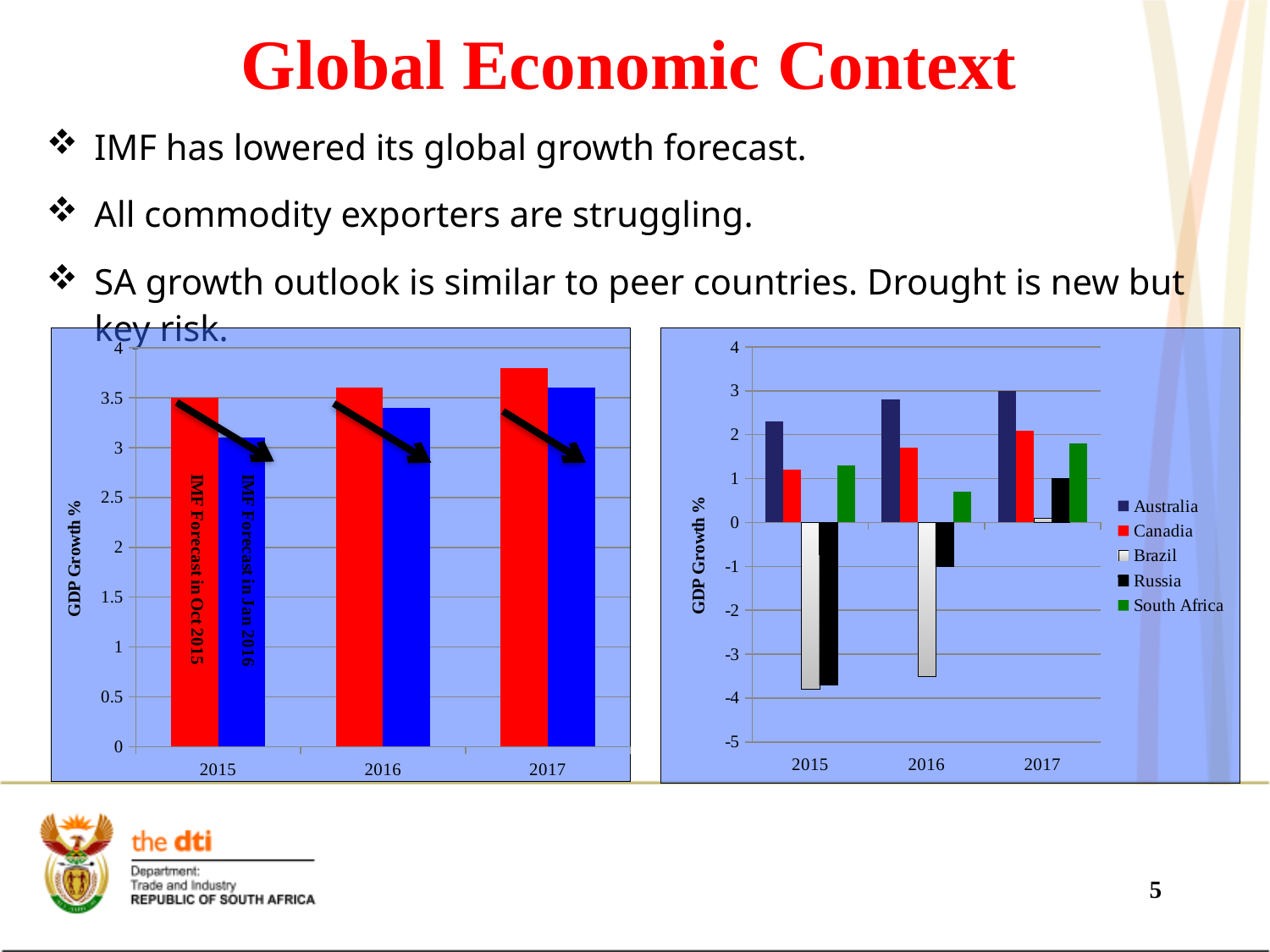
How many series does the legend of the right chart list? 5 What kind of chart is the left chart on the slide? bar chart In the right chart, what is the value for Australia in 2017? 3 How many years are shown on the x axis of the left chart? 3 In the left chart, what is the IMF Forecast in Oct 2015 value for 2015? 3.5 In the right chart, which country has the highest value in 2016? Australia In the right chart, what is the value for Russia in 2016? -1 In the left chart, for each year, is the IMF Forecast in Jan 2016 higher or lower than the IMF Forecast in Oct 2015? lower In the right chart, which colour represents South Africa? green In the right chart, is the value for Brazil in 2016 greater or less than -3? less In the left chart, do the IMF Forecast in Oct 2015 values rise or fall from 2015 to 2017? rise In the left chart, is the IMF Forecast in Jan 2016 value for 2015 greater or less than 3.5? less